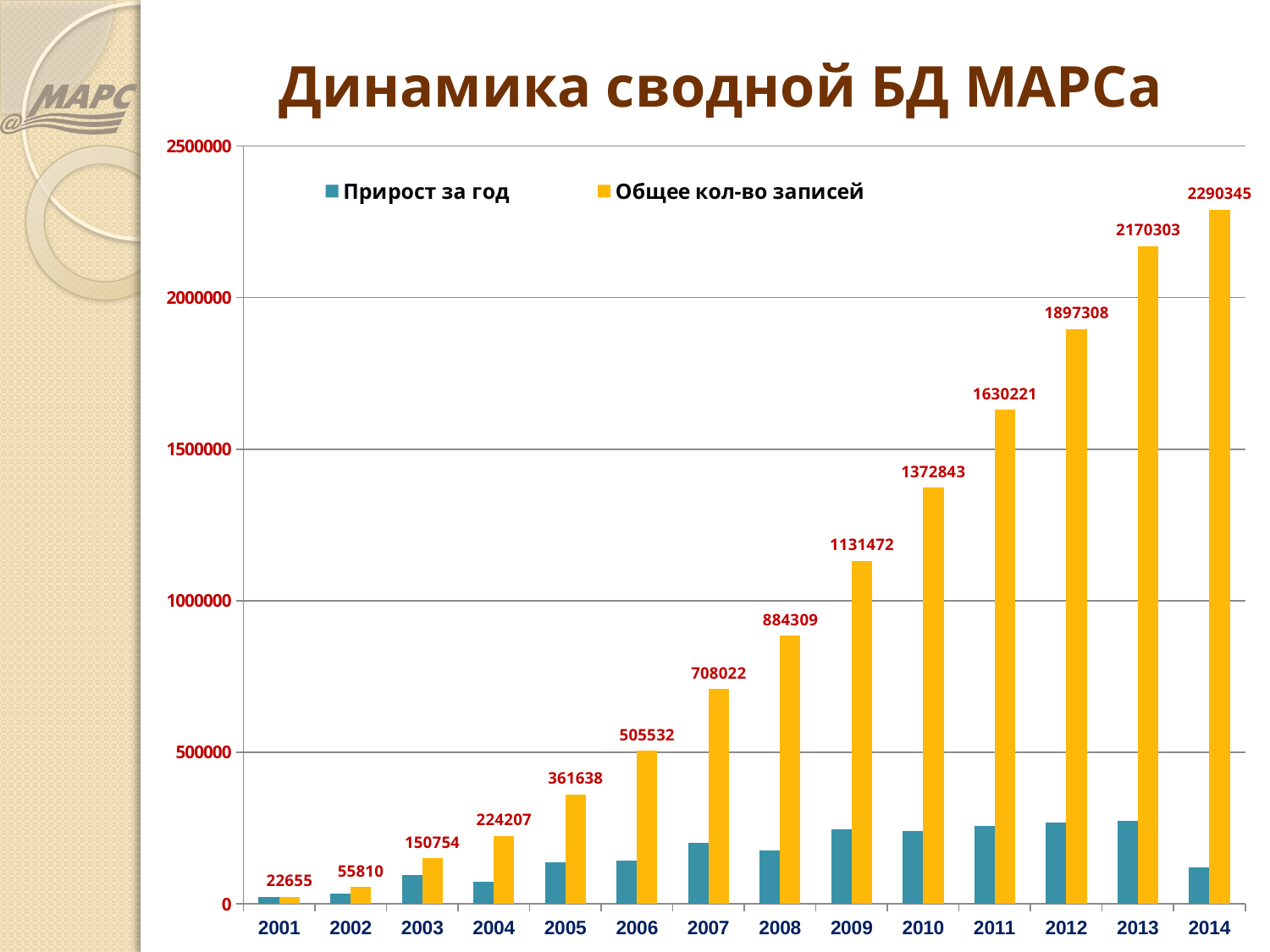
Which year has a larger "Общее кол-во записей" value, 2008 or 2009? 2009 What is the value of "Общее кол-во записей" for 2007? 708022 Does the "Общее кол-во записей" series rise or fall from 2001 to 2014? rise How many years are shown on the x axis? 14 What is the difference between the "Общее кол-во записей" values for 2010 and 2009? 241371 How many series does the legend list? 2 What is the difference between the "Общее кол-во записей" values for 2014 and 2013? 120042 Is the value of "Прирост за год" for 2013 greater or less than 500000? less What is the value of "Общее кол-во записей" for 2001? 22655 Which year has the lowest value for "Общее кол-во записей"? 2001 What is the value of "Общее кол-во записей" for 2014? 2290345 Which year has the highest value for "Общее кол-во записей"? 2014